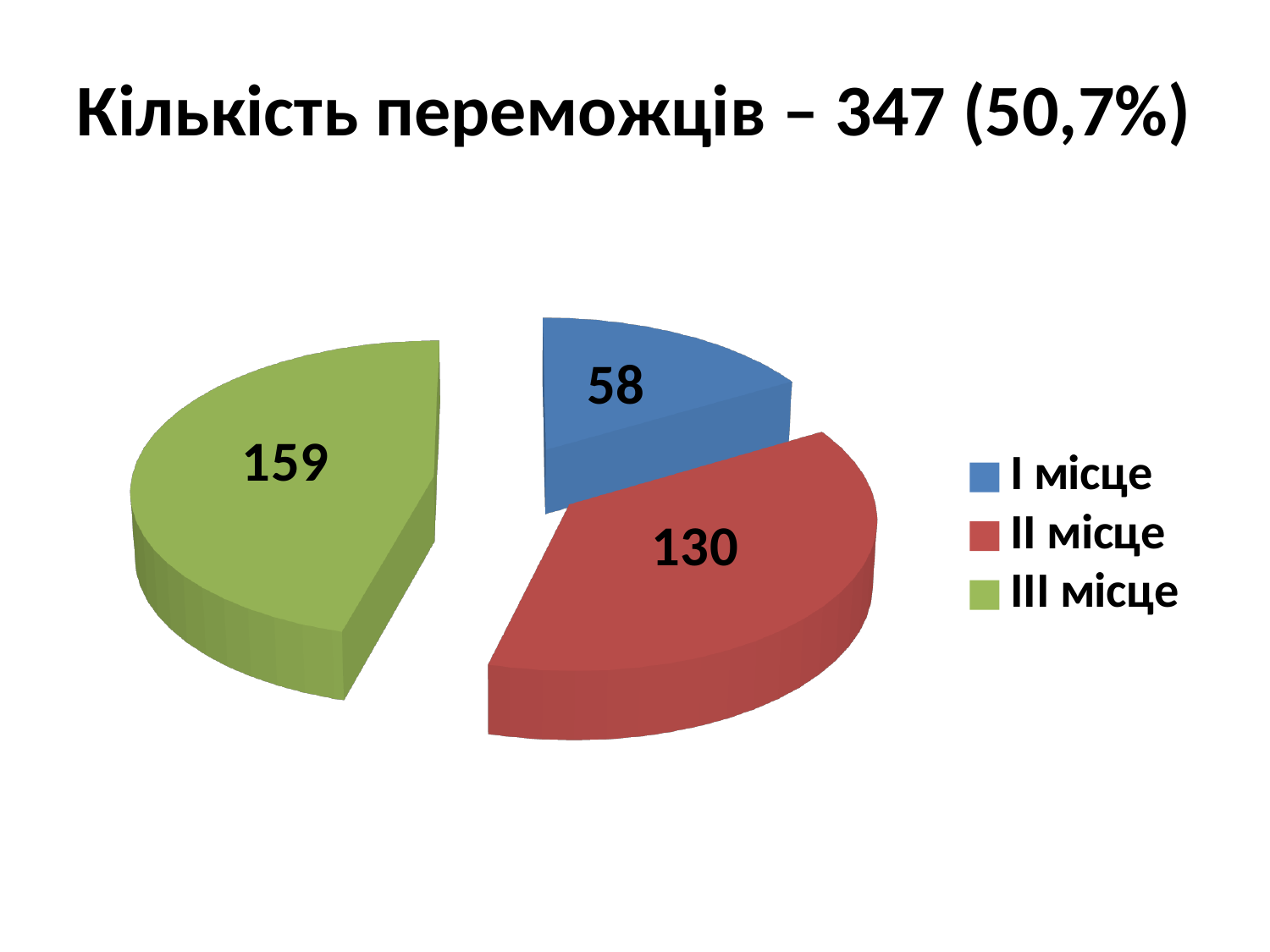
What is the difference between the values for III місце and II місце? 29 How many slices does the pie chart have? 3 What kind of chart is shown on the slide? Pie chart What colour is the slice for III місце? Green Which category has the largest slice of the pie? III місце Which category has the smallest slice of the pie? I місце What is the value for III місце? 159 What is the value for I місце? 58 What is the value for II місце? 130 What is the total of all slices in the pie chart? 347 Which is larger, the value for II місце or the value for I місце? II місце What is the difference between the values for II місце and I місце? 72